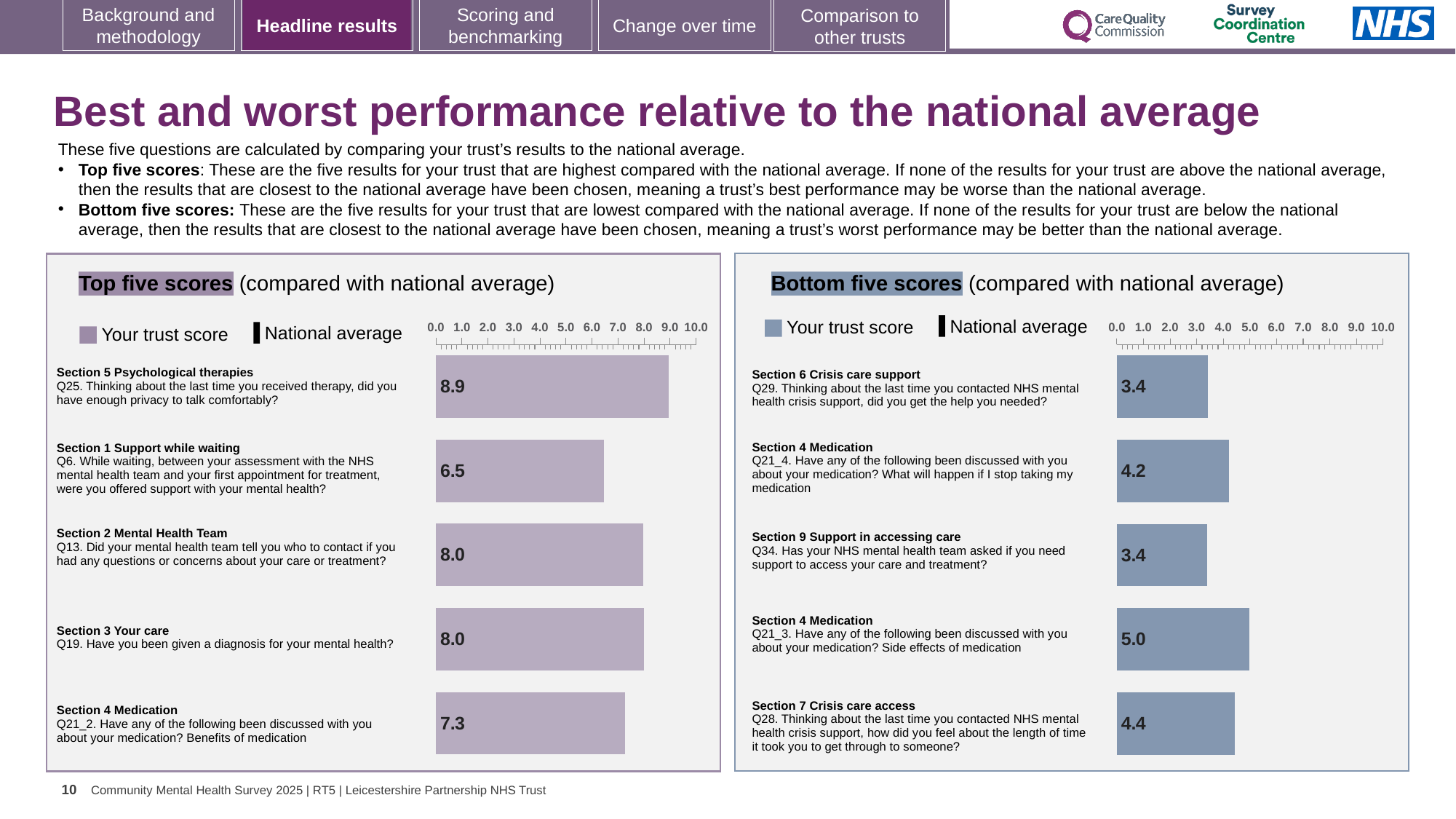
How many bars are plotted in the Bottom five scores chart? 5 What type of chart is used in the Top five scores panel? Bar chart In the Top five scores chart, what is the trust score for Q6 (Section 1 Support while waiting)? 6.5 In the Top five scores chart, what is the trust score for Q25 (Section 5 Psychological therapies)? 8.9 In the Bottom five scores chart, what is the trust score for Q21_3 (Side effects of medication)? 5.0 In the Bottom five scores chart, which has the larger trust score, Q21_4 or Q28? Q28 In the Bottom five scores chart, which question has the highest trust score? Q21_3 (Section 4 Medication, Side effects of medication) In the Top five scores chart, which question has the lowest trust score? Q6 (Section 1 Support while waiting) In the Bottom five scores chart, is the trust score for Q29 greater or less than 4.0? less In the Top five scores chart, which question has the highest trust score? Q25 (Section 5 Psychological therapies) In the Bottom five scores chart, what is the difference between the trust scores for Q21_3 and Q29? 1.6 In the Top five scores chart, what is the difference between the trust scores for Q25 and Q6? 2.4